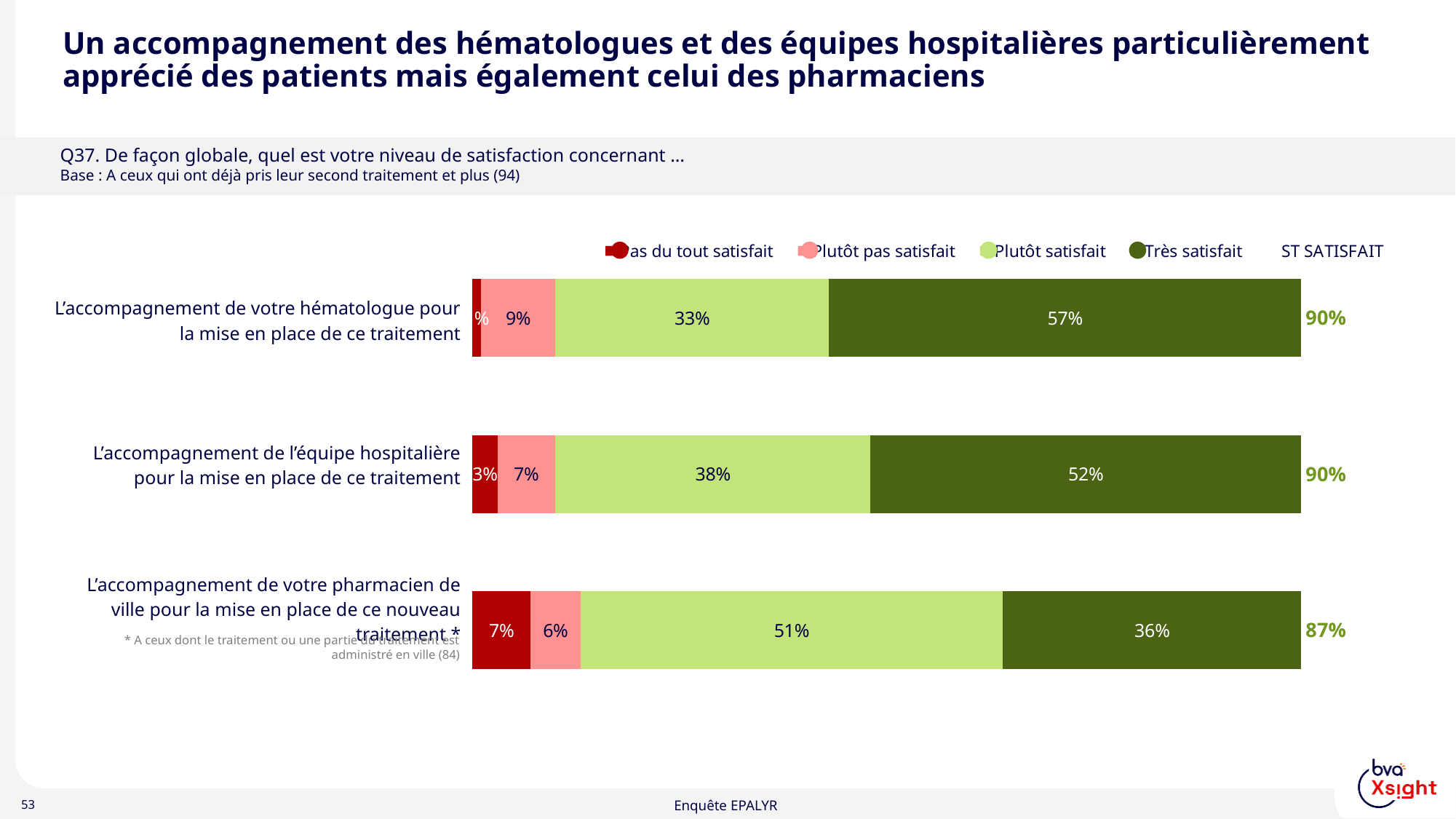
How many categories (items) are plotted in the chart? 3 Which item has the highest 'Très satisfait' value? L'accompagnement de votre hématologue pour la mise en place de ce traitement What is the ST SATISFAIT value for 'L'accompagnement de votre pharmacien de ville pour la mise en place de ce nouveau traitement'? 87% Which is larger: the 'Très satisfait' value for the équipe hospitalière item or for the pharmacien de ville item? L'accompagnement de l'équipe hospitalière pour la mise en place de ce traitement What type of chart is shown on the slide? stacked bar chart Which item has the lowest ST SATISFAIT value? L'accompagnement de votre pharmacien de ville pour la mise en place de ce nouveau traitement What is the 'Plutôt pas satisfait' value for 'L'accompagnement de votre pharmacien de ville pour la mise en place de ce nouveau traitement'? 6% What is the difference between the 'Plutôt satisfait' values for the pharmacien de ville item and the hématologue item? 18% What is the 'Plutôt satisfait' value for 'L'accompagnement de l'équipe hospitalière pour la mise en place de ce traitement'? 38% What is the 'Très satisfait' value for 'L'accompagnement de votre hématologue pour la mise en place de ce traitement'? 57% How many series does the legend list (excluding the ST SATISFAIT column)? 4 What is the combined 'Plutôt satisfait' and 'Très satisfait' total for 'L'accompagnement de l'équipe hospitalière pour la mise en place de ce traitement'? 90%